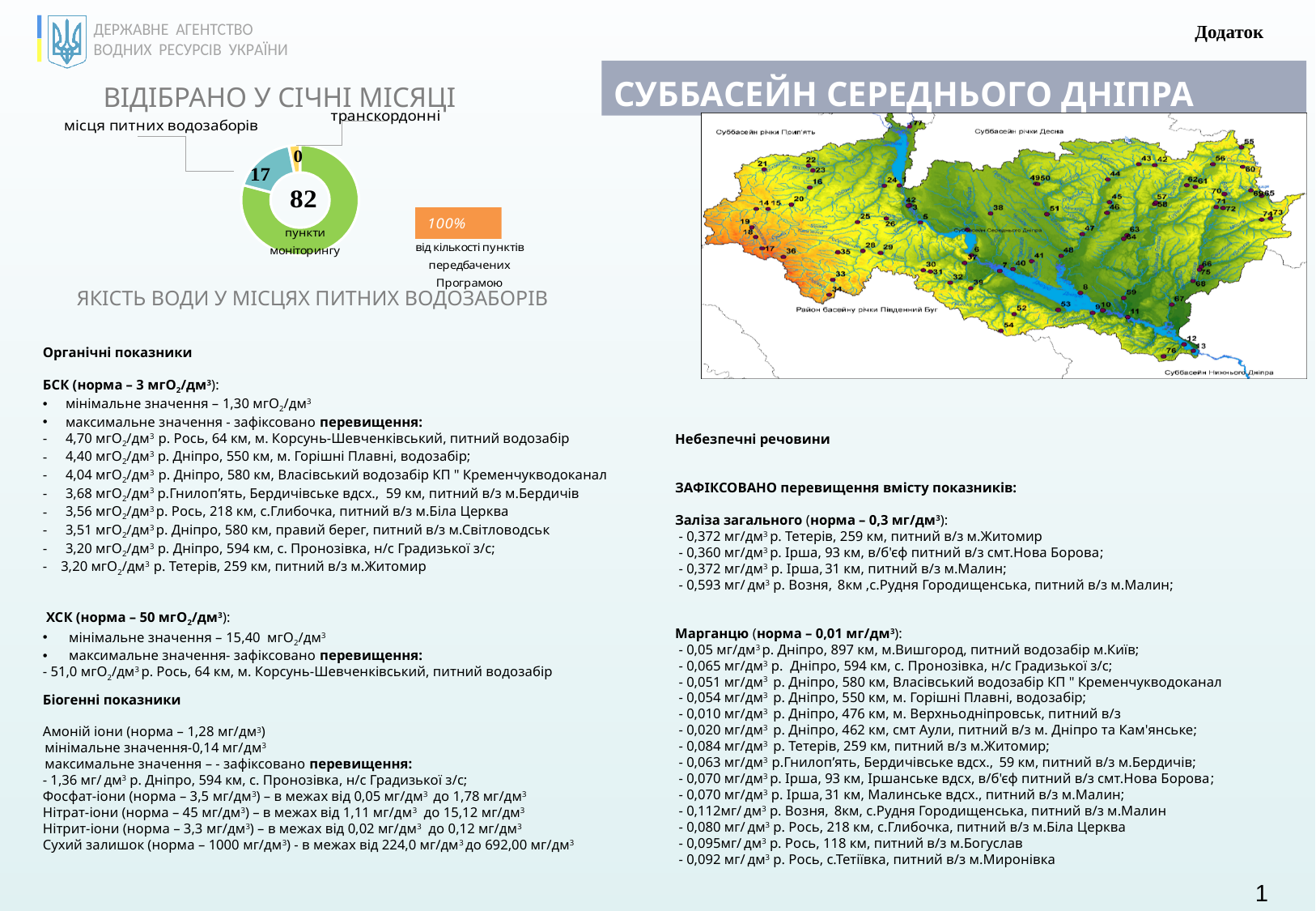
What colour is the largest segment of the doughnut chart? Green In the doughnut chart, what is the difference between the value for "пункти моніторингу" and the value for "місця питних водозаборів"? 65 What is the title above the doughnut chart? ВІДІБРАНО У СІЧНІ МІСЯЦІ In the doughnut chart, what is the value for "місця питних водозаборів"? 17 Which category in the doughnut chart has the highest value? пункти моніторингу Which category in the doughnut chart has the lowest value? транскордонні In the doughnut chart, what is the value for "пункти моніторингу"? 82 How many categories are shown in the doughnut chart? 3 In the doughnut chart, what is the value for "транскордонні"? 0 In the doughnut chart, which is larger: "місця питних водозаборів" or "транскордонні"? місця питних водозаборів What kind of chart is shown under the title "ВІДІБРАНО У СІЧНІ МІСЯЦІ"? Doughnut chart